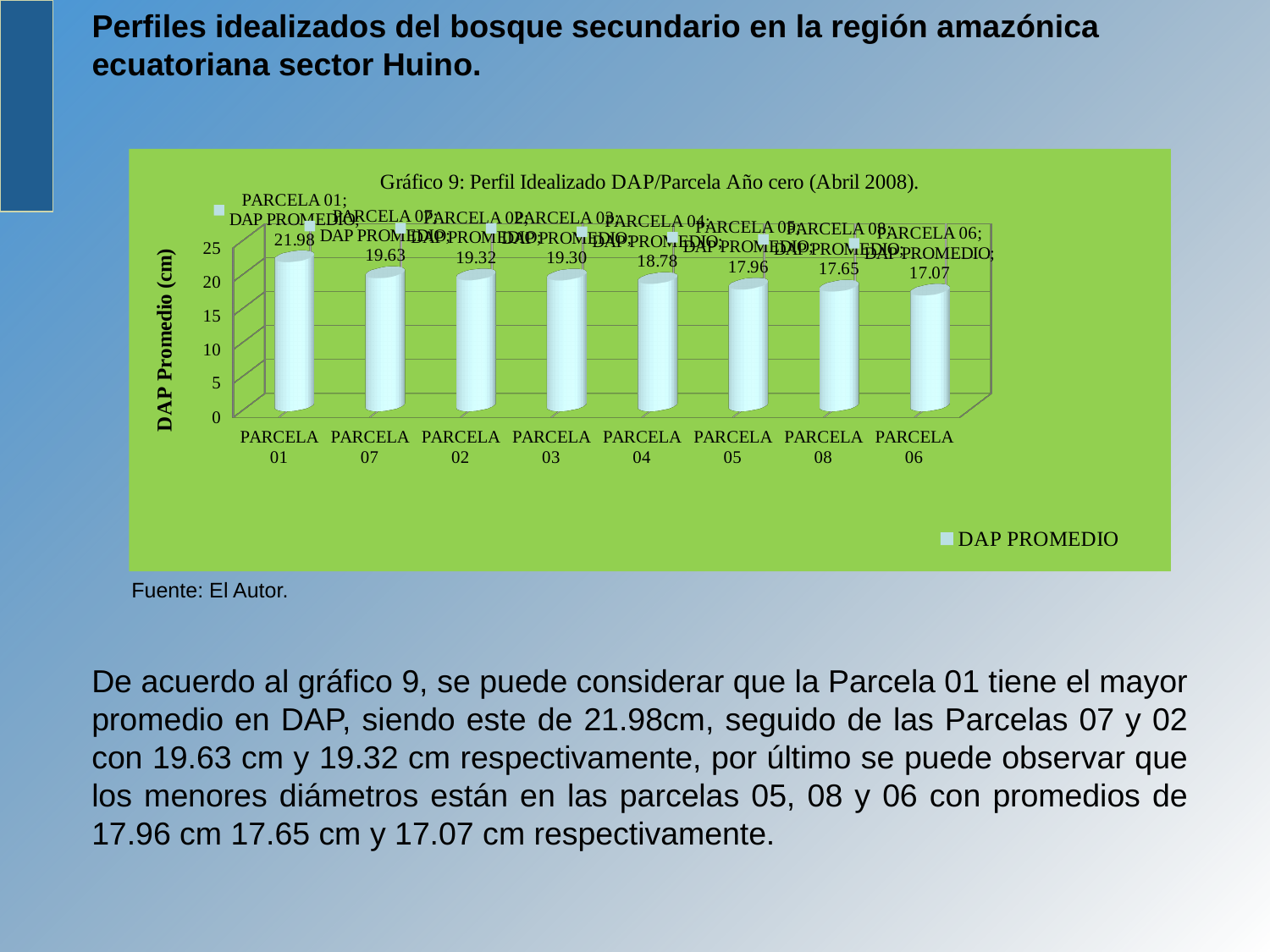
How many series does the chart legend list? 1 Which parcela has the highest DAP PROMEDIO? PARCELA 01 What is the DAP PROMEDIO value for PARCELA 04? 18.78 Which has a larger DAP PROMEDIO, PARCELA 05 or PARCELA 08? PARCELA 05 Is the DAP PROMEDIO value for PARCELA 02 greater or less than 20? less What is the DAP PROMEDIO value for PARCELA 06? 17.07 What is the label of the vertical axis of the chart? DAP Promedio (cm) What kind of chart is shown on the slide? bar chart What is the difference between the DAP PROMEDIO of PARCELA 01 and PARCELA 07? 2.35 What is the DAP PROMEDIO value for PARCELA 01? 21.98 Which parcela has the lowest DAP PROMEDIO? PARCELA 06 How many parcelas are shown on the x axis of the chart? 8